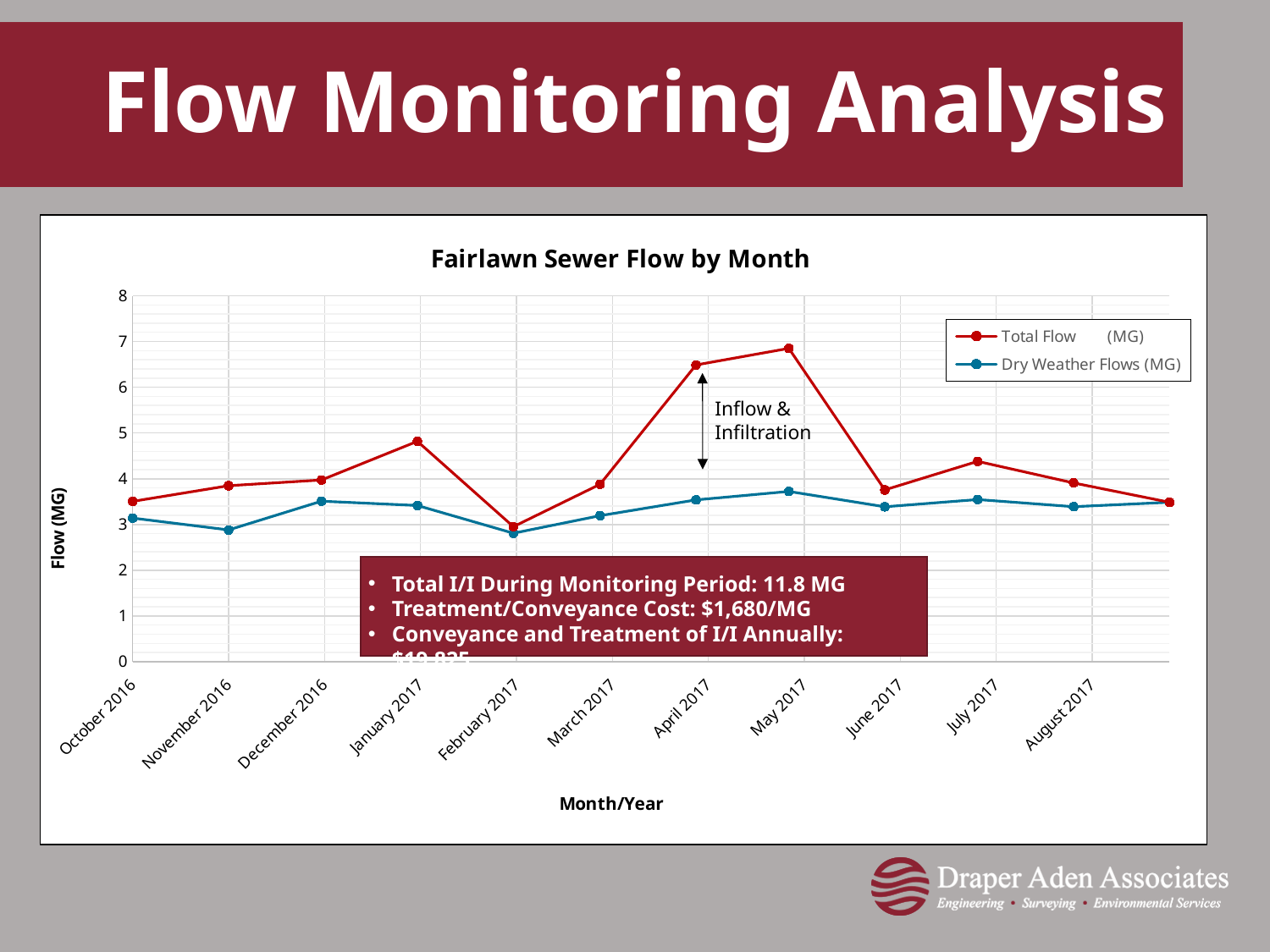
What type of chart is shown on the slide? Line chart In April 2017, which series has the larger value, Total Flow (MG) or Dry Weather Flows (MG)? Total Flow (MG) Is the Dry Weather Flows (MG) value for May 2017 greater or less than 4? less How many months are plotted along the x axis? 11 Does Total Flow (MG) rise or fall from March 2017 to May 2017? Rise Is the Total Flow (MG) value for January 2017 greater or less than 4? greater In which month is Total Flow (MG) lowest? February 2017 Is the Total Flow (MG) value for April 2017 greater or less than 6? greater How many series does the legend list? 2 In which month is Total Flow (MG) highest? May 2017 What does the arrow annotation between the two lines in April 2017 label? Inflow & Infiltration What is the title of the chart? Fairlawn Sewer Flow by Month